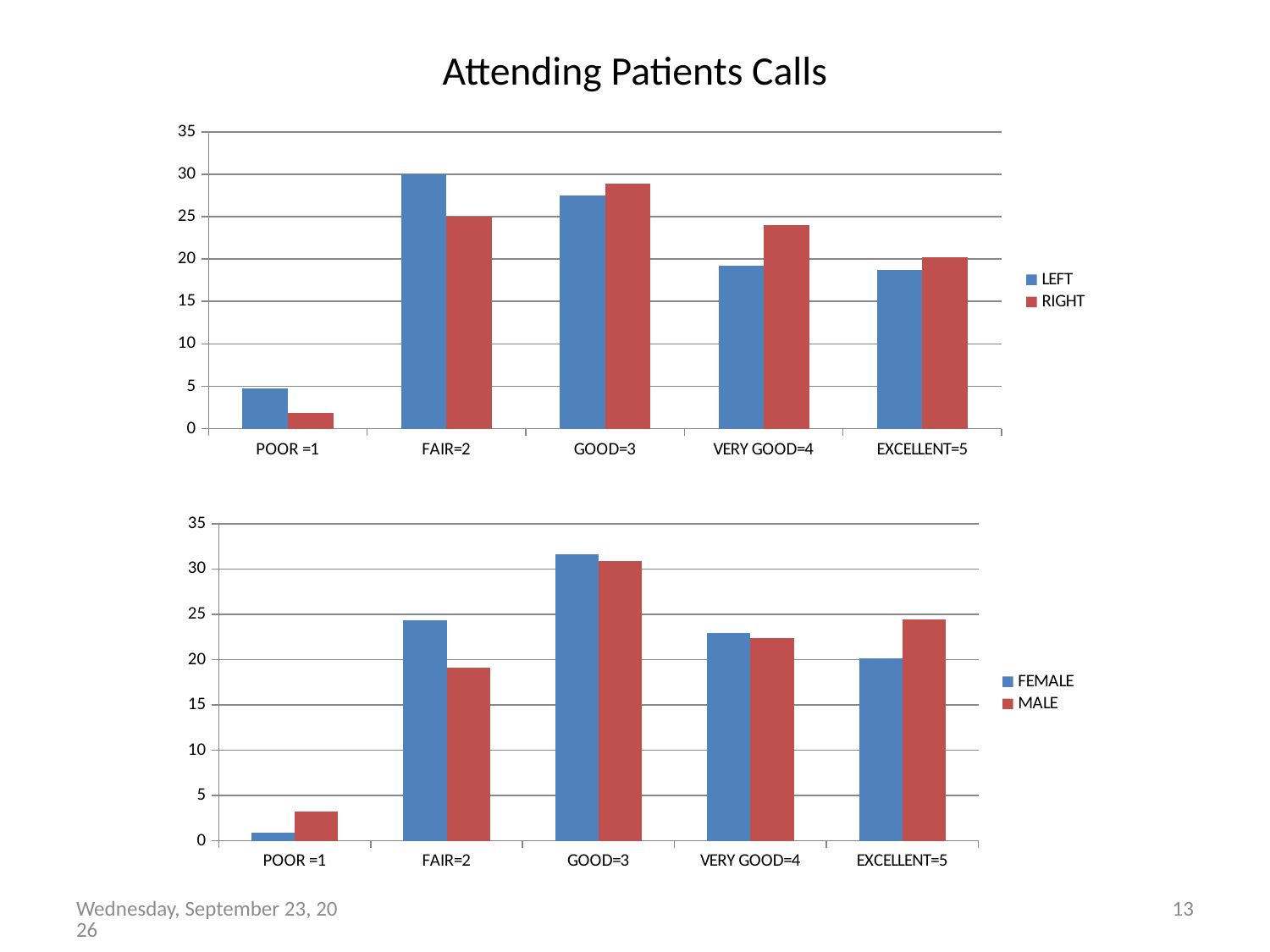
In the bottom chart, for EXCELLENT=5, which is larger: FEMALE or MALE? MALE In the top chart, for FAIR=2, which is larger: LEFT or RIGHT? LEFT What kind of chart is the top chart on the slide? bar chart In the bottom chart, what are the two series listed in the legend? FEMALE and MALE In the top chart, which category has the highest LEFT value? FAIR=2 In the top chart, how many categories are shown on the x axis? 5 In the bottom chart, is the FEMALE value for FAIR=2 greater or less than 20? greater In the bottom chart, which category has the highest MALE value? GOOD=3 In the top chart, which category has the lowest RIGHT value? POOR =1 In the bottom chart, which category has the lowest FEMALE value? POOR =1 In the top chart, is the RIGHT value for VERY GOOD=4 greater or less than 20? greater In the top chart, how many series does the legend list? 2